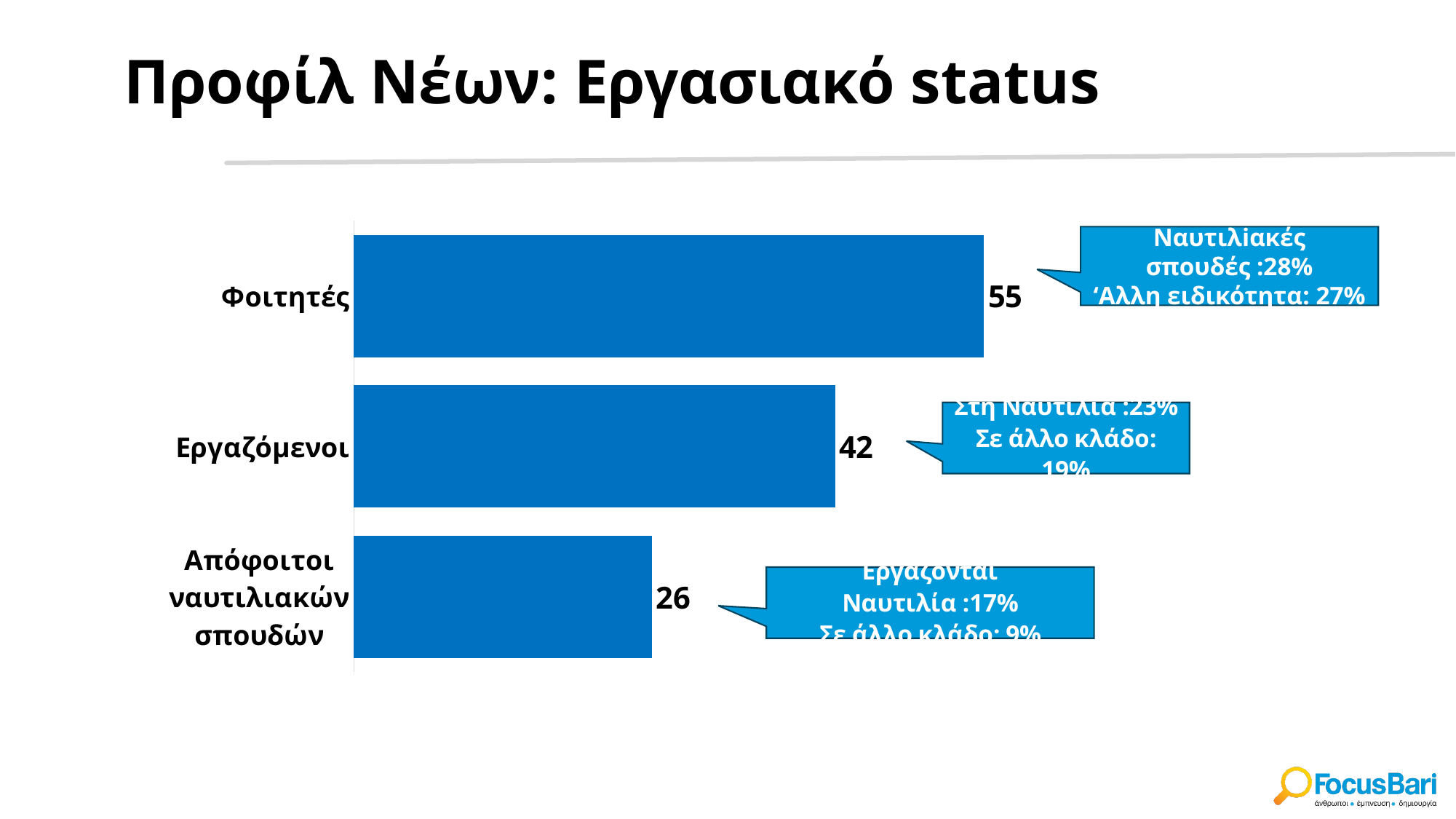
Which category has the lowest value? Απόφοιτοι ναυτιλιακών σπουδών Which category has the highest value? Φοιτητές According to the callout next to the Φοιτητές bar, what percentage is for Ναυτιλιακές σπουδές? 28% What is the value for Εργαζόμενοι? 42 How many categories are shown in the chart? 3 What is the value for Απόφοιτοι ναυτιλιακών σπουδών? 26 What is the difference between the values for Εργαζόμενοι and Απόφοιτοι ναυτιλιακών σπουδών? 16 What is the difference between the values for Φοιτητές and Εργαζόμενοι? 13 What is the value for Φοιτητές? 55 Which is larger, the value for Εργαζόμενοι or the value for Απόφοιτοι ναυτιλιακών σπουδών? Εργαζόμενοι What is the title of the slide? Προφίλ Νέων: Εργασιακό status What kind of chart is shown on the slide? Bar chart